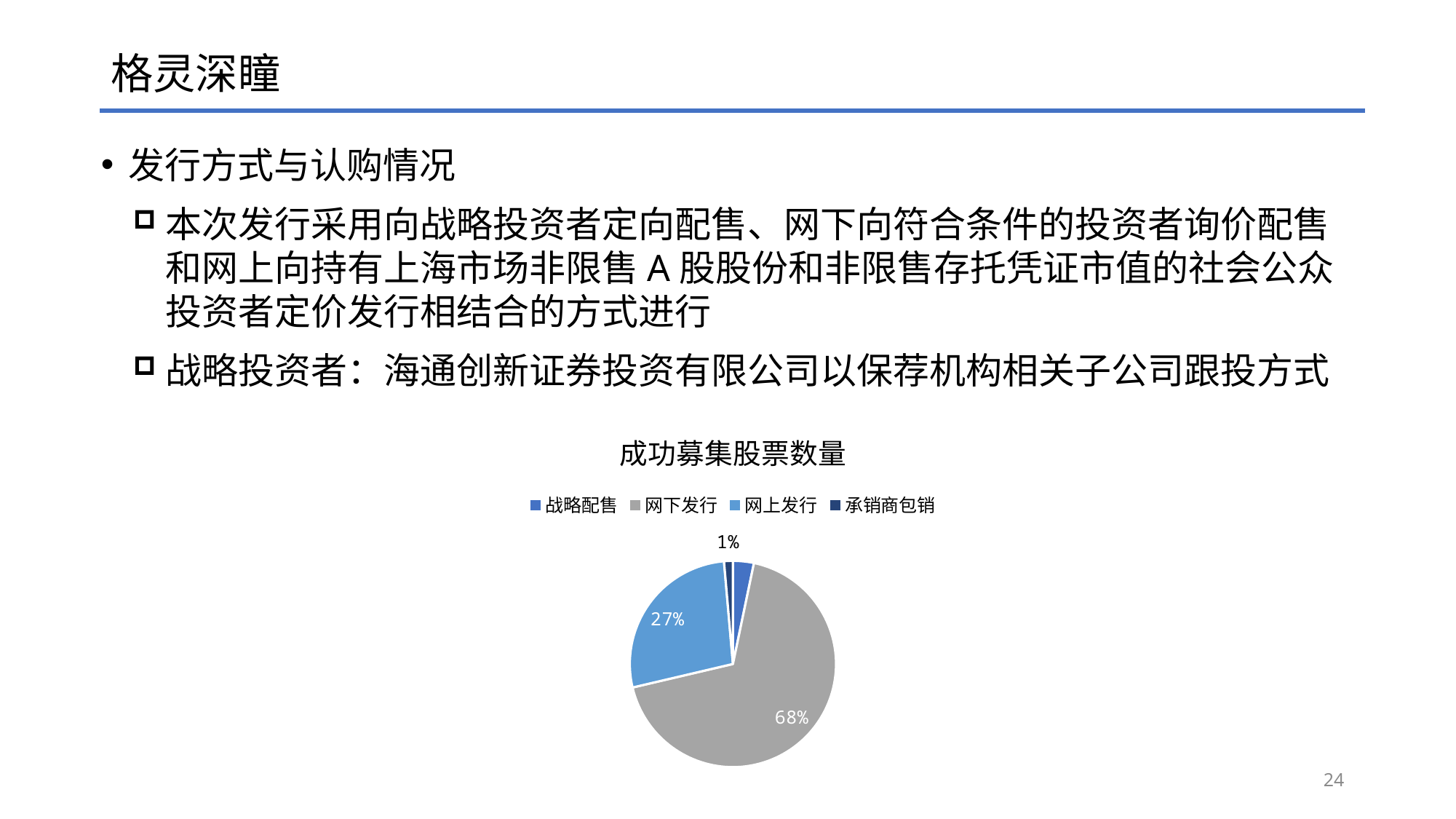
What percentage label is shown for the 承销商包销 slice? 1% What share of the pie does 网下发行 account for? 68% What do the 网下发行 and 网上发行 slices add up to? 95% Which category has the smallest slice of the pie? 承销商包销 What share of the pie does 网上发行 account for? 27% Which is larger, the slice for 网下发行 or the slice for 网上发行? 网下发行 What is the difference in percentage points between the 网下发行 slice and the 网上发行 slice? 41% What colour is the 网下发行 slice in the pie chart? gray Which category has the largest slice of the pie? 网下发行 How many categories does the chart's legend list? 4 What kind of chart is shown on the slide? pie chart What is the title of the chart? 成功募集股票数量